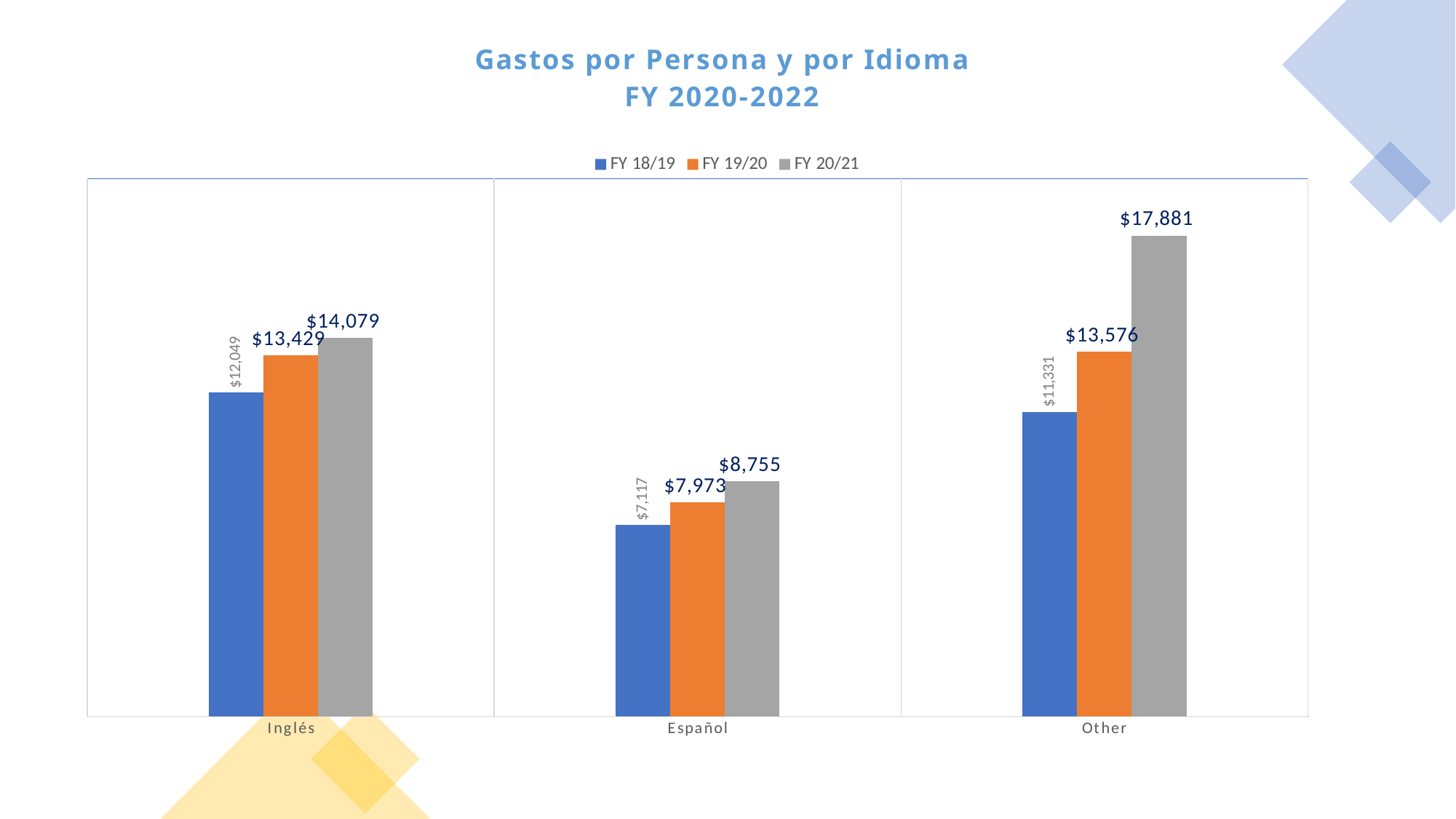
What kind of chart is shown on the slide? Bar chart Which is larger: the FY 19/20 value for Inglés or the FY 19/20 value for Other? Other What is the difference between the FY 20/21 values for Inglés and Español? $5,324 What is the FY 20/21 value for Inglés? $14,079 Which category has the lowest FY 18/19 value? Español What is the FY 19/20 value for Español? $7,973 What is the FY 20/21 value for Other? $17,881 What is the FY 18/19 value for Inglés? $12,049 Which category has the highest FY 20/21 value? Other What is the difference between the FY 20/21 and FY 18/19 values for Other? $6,550 How many series does the legend list? 3 How many categories are shown on the x axis? 3